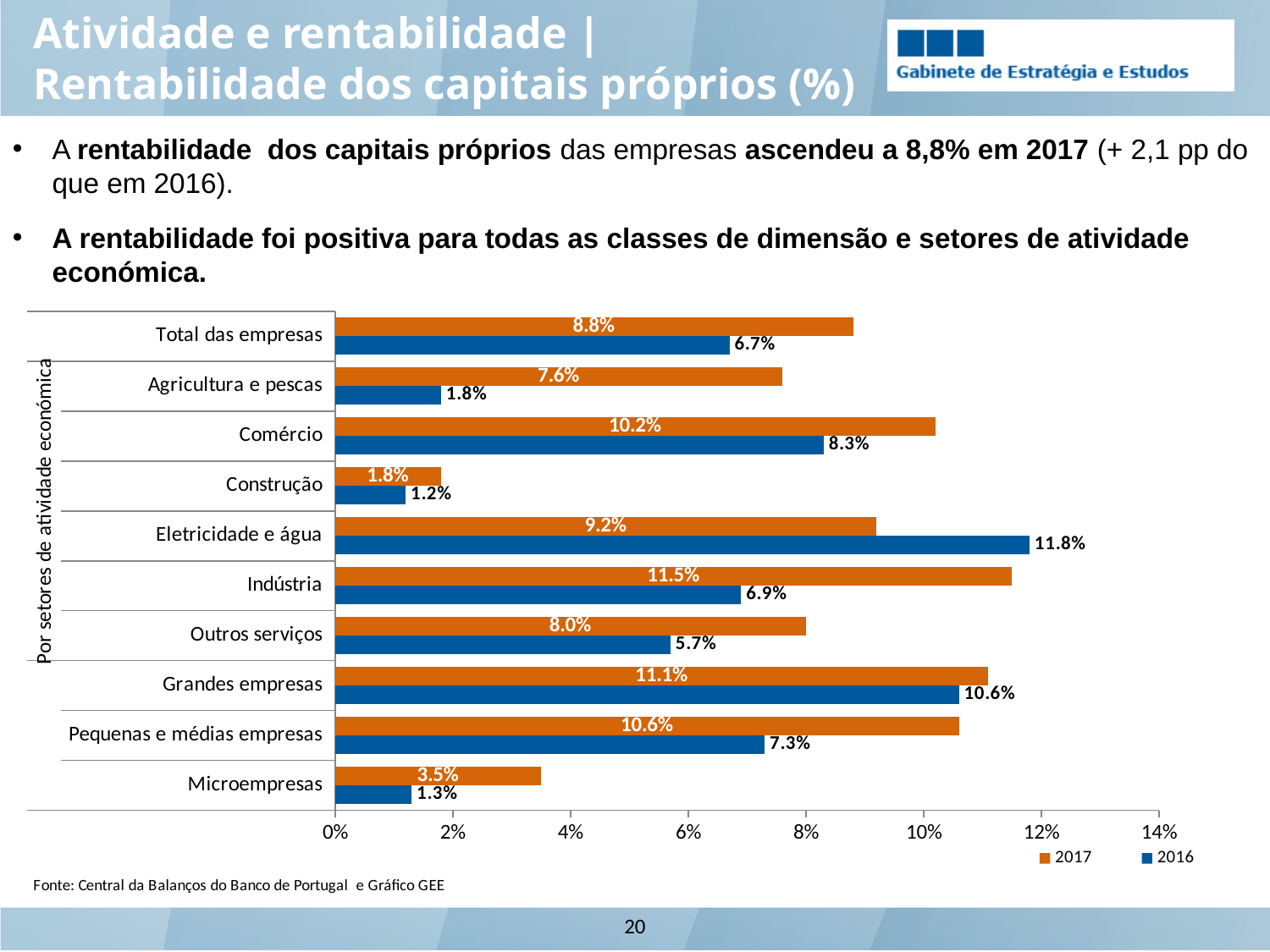
What is the value for Comércio in 2017? 10.2% What is the difference between the 2017 and 2016 values for Total das empresas? 2.1 pp Which category has the highest value in the 2017 series? Indústria For Eletricidade e água, which year has the larger value, 2017 or 2016? 2016 What is the value for Eletricidade e água in 2016? 11.8% Which category has the lowest value in the 2016 series? Construção How many categories are shown on the chart? 10 What is the value for Microempresas in 2017? 3.5% Which category has the highest value in the 2016 series? Eletricidade e água How many series does the legend list? 2 What kind of chart is shown on the slide? Bar chart What is the difference between the 2017 and 2016 values for Agricultura e pescas? 5.8 pp